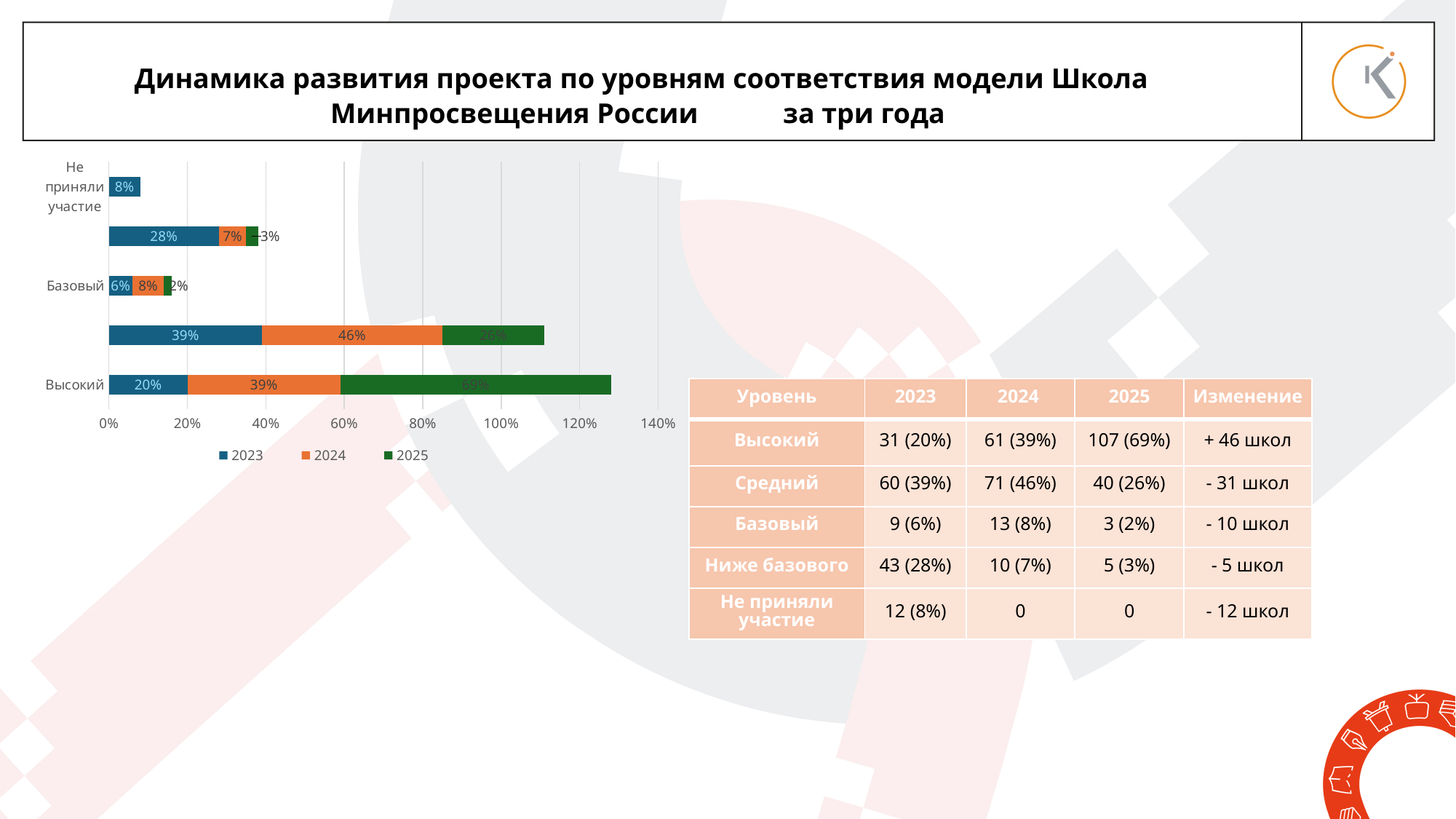
What is the difference between the 2025 and 2023 values for the Высокий category? 49% What are the entries listed in the chart legend? 2023, 2024, 2025 What is the 2023 value for the Базовый category? 6% How many series does the chart legend list? 3 Which series has the highest value in the Высокий category? 2025 Which is larger for 2024: the value for Высокий or the value for Базовый? Высокий What is the 2024 value for the Высокий category? 39% What is the total of the stacked bar for the Базовый category? 16% What kind of chart is shown on the slide? Stacked bar chart What is the total of the stacked bar for the Высокий category? 128% What is the 2025 value for the Высокий category? 69% What is the 2023 value for the Не приняли участие category? 8%